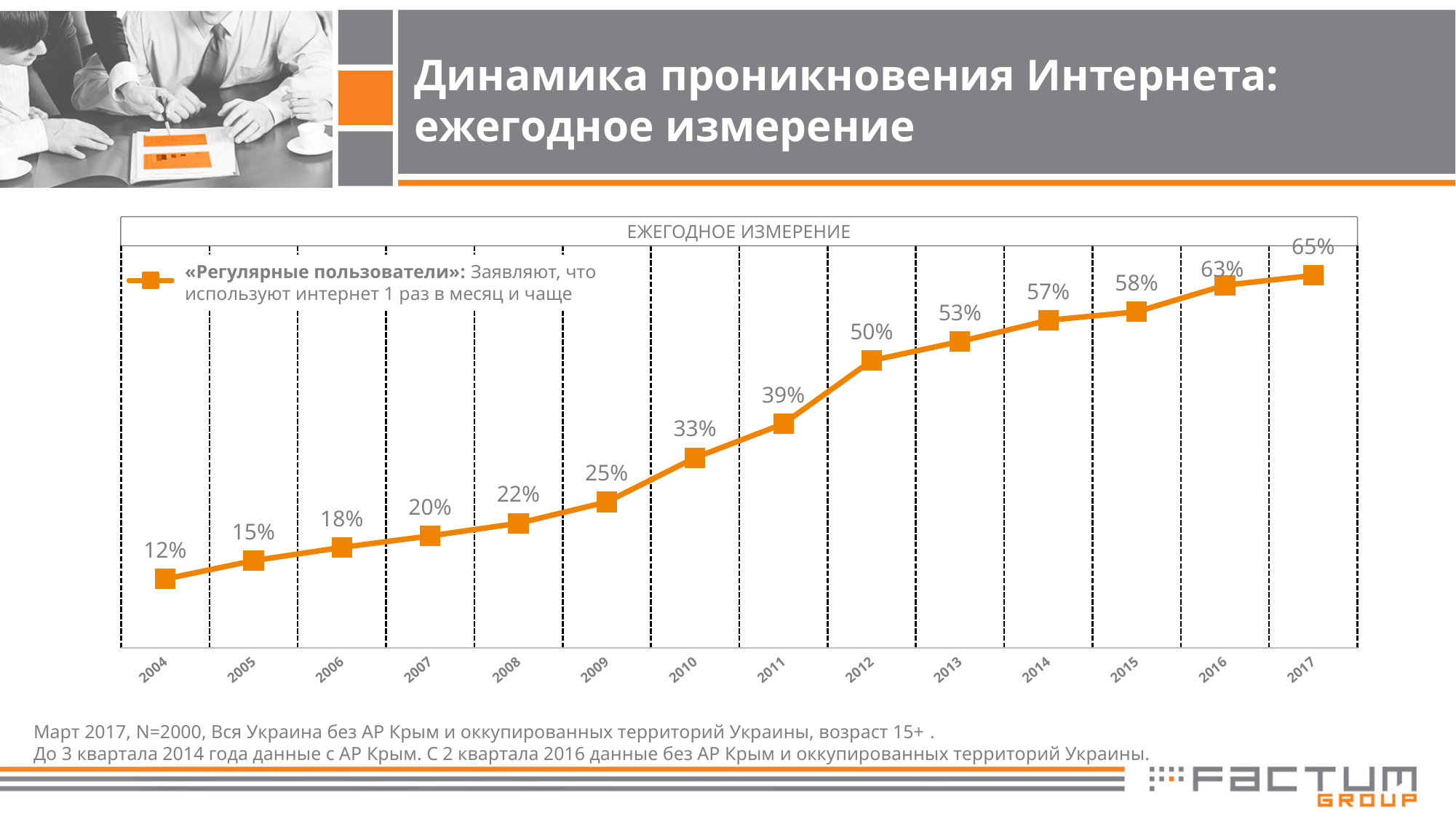
What kind of chart is this? line chart Which year has the lowest value? 2004 Which is larger, the value for 2009 or the value for 2010? 2010 What is the difference between the values for 2012 and 2011? 11% What is the value for 2004? 12% What is the difference between the values for 2017 and 2004? 53% Which year has the highest value? 2017 What is the value for 2012? 50% How many years are plotted on the chart? 14 What is the title shown at the top of the chart area? ЕЖЕГОДНОЕ ИЗМЕРЕНИЕ Do the values rise or fall from 2004 to 2017? rise What is the value for 2017? 65%